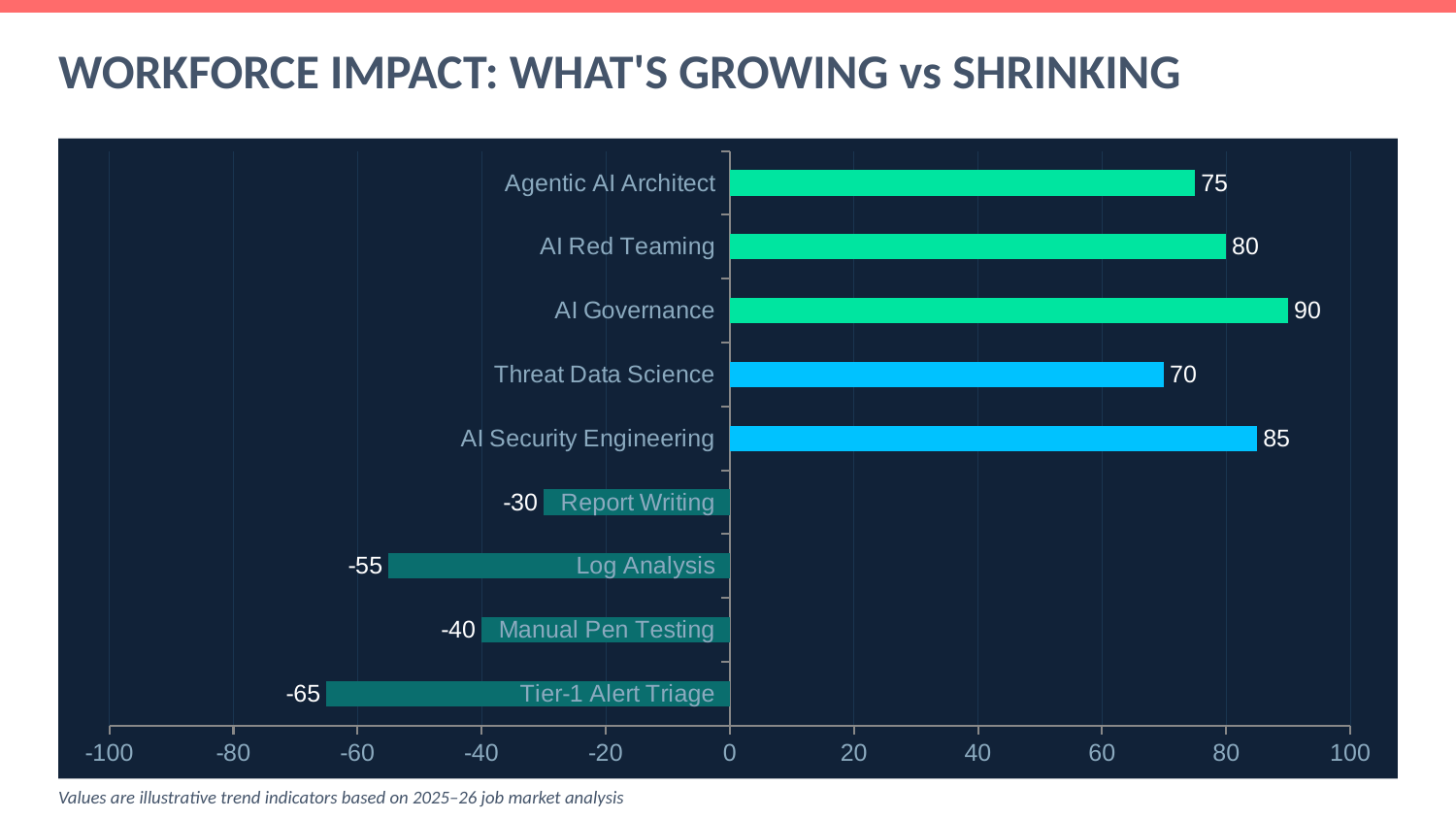
What is the value for Threat Data Science? 70 Which is larger, the value for AI Red Teaming or the value for Threat Data Science? AI Red Teaming What is the difference between the values for AI Security Engineering and Agentic AI Architect? 10 Which category has the lowest value? Tier-1 Alert Triage Which category has the highest value? AI Governance What is the title of the slide? WORKFORCE IMPACT: WHAT'S GROWING vs SHRINKING Is the value for Log Analysis greater or less than -40? less What is the value for AI Governance? 90 How many categories are shown in the chart? 9 What kind of chart is shown on the slide? bar chart How many categories have negative values? 4 What is the value for Tier-1 Alert Triage? -65